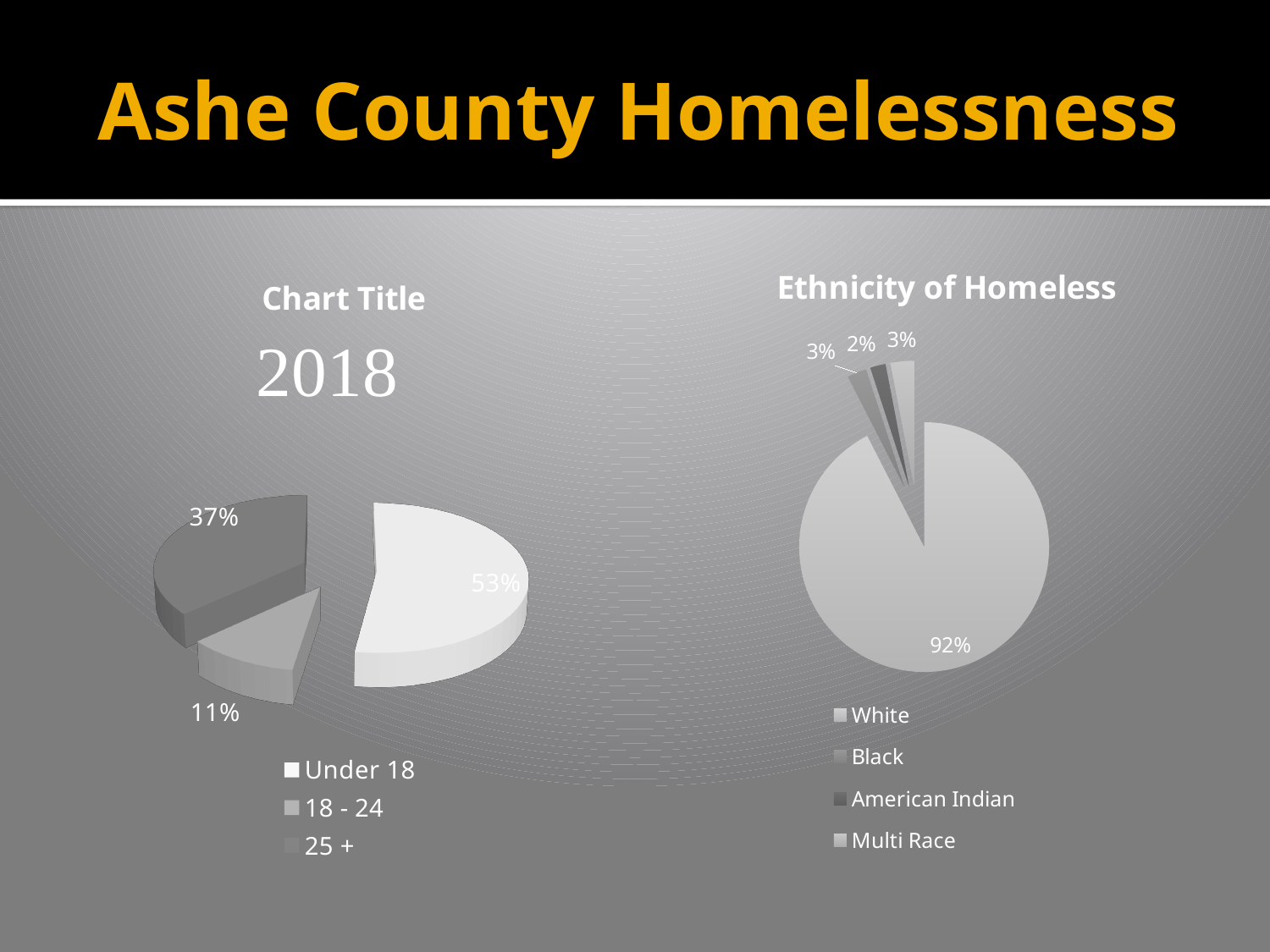
On the left chart (Chart Title), what is the percentage of the smallest slice? 11% On the left chart (Chart Title), which category has the largest slice? Under 18 On the Ethnicity of Homeless chart, which is larger: the White slice or the slice labelled 3%? White What kind of chart is the Ethnicity of Homeless chart? pie chart On the Ethnicity of Homeless chart, what percentage is shown for White? 92% How many slices does the left chart (Chart Title) have? 3 What year is displayed on the left chart (Chart Title)? 2018 On the left chart (Chart Title), what percentage is shown for Under 18? 53% On the Ethnicity of Homeless chart, which category has the largest share? White How many categories does the legend of the Ethnicity of Homeless chart list? 4 On the left chart (Chart Title), what is the difference between the largest slice (53%) and the smallest slice (11%)? 42% What kind of chart is the chart on the left of the slide? pie chart